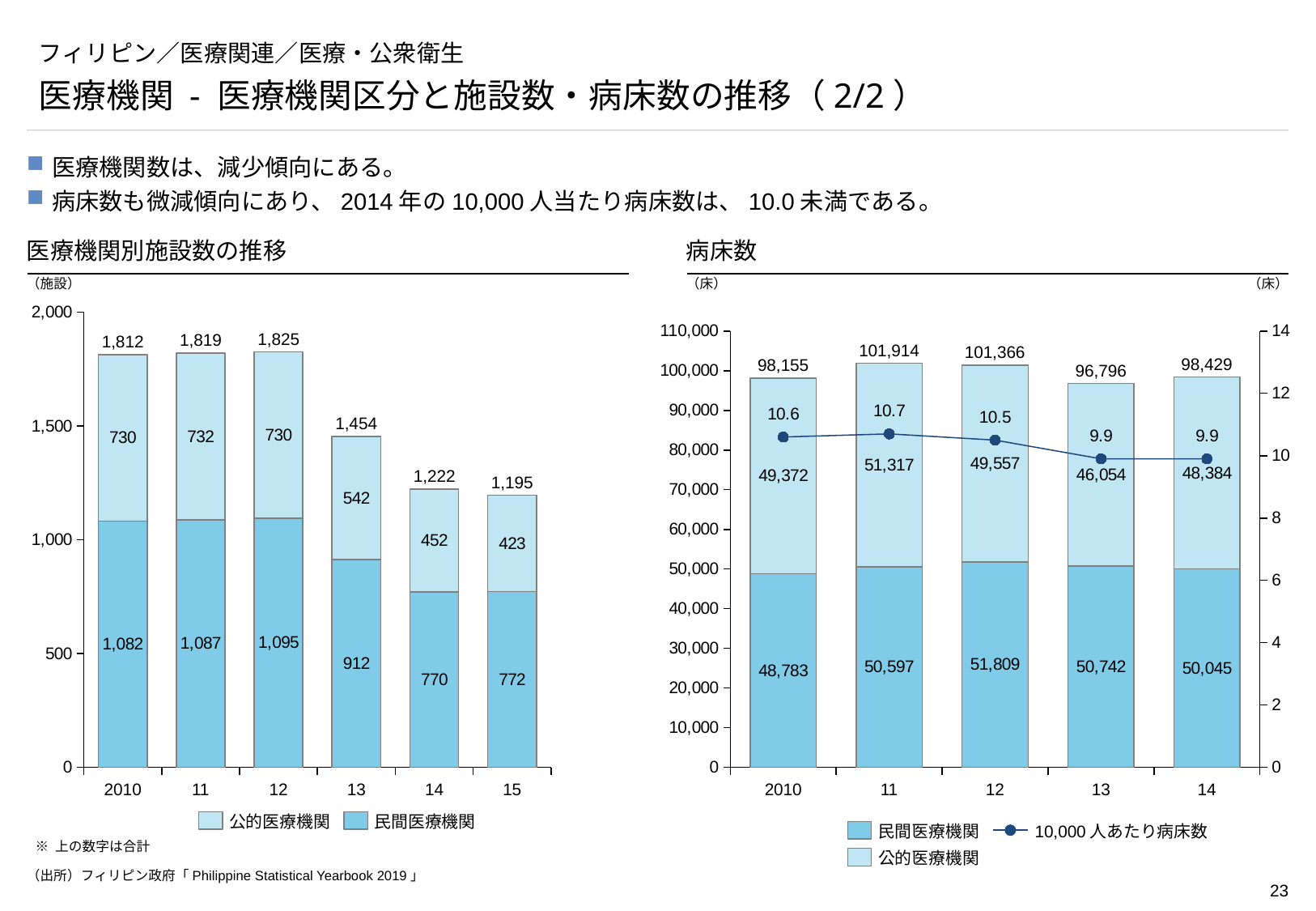
In the left chart (医療機関別施設数の推移), what is the difference between the 公的医療機関 values for 2012 and 2013? 188 In the right chart (病床数), what is the number of beds per 10,000 people in 2013? 9.9 In the left chart (医療機関別施設数の推移), do the total values rise or fall from 2012 to 2015? fall In the right chart (病床数), what is the total number of beds in 2011? 101,914 In the left chart (医療機関別施設数の推移), what is the value for 民間医療機関 in 2013? 912 In the left chart (医療機関別施設数の推移), which year has the lowest total number of facilities? 15 In the right chart (病床数), is the 民間医療機関 value for 2012 larger than the 公的医療機関 value for 2012? Yes In the right chart (病床数), which year has the highest total number of beds? 11 In the right chart (病床数), what is the value for 公的医療機関 in 2014? 48,384 In the right chart (病床数), how many series does the legend list? 3 In the left chart (医療機関別施設数の推移), how many years are shown on the x axis? 6 In the left chart (医療機関別施設数の推移), what is the total number of facilities in 2012? 1,825